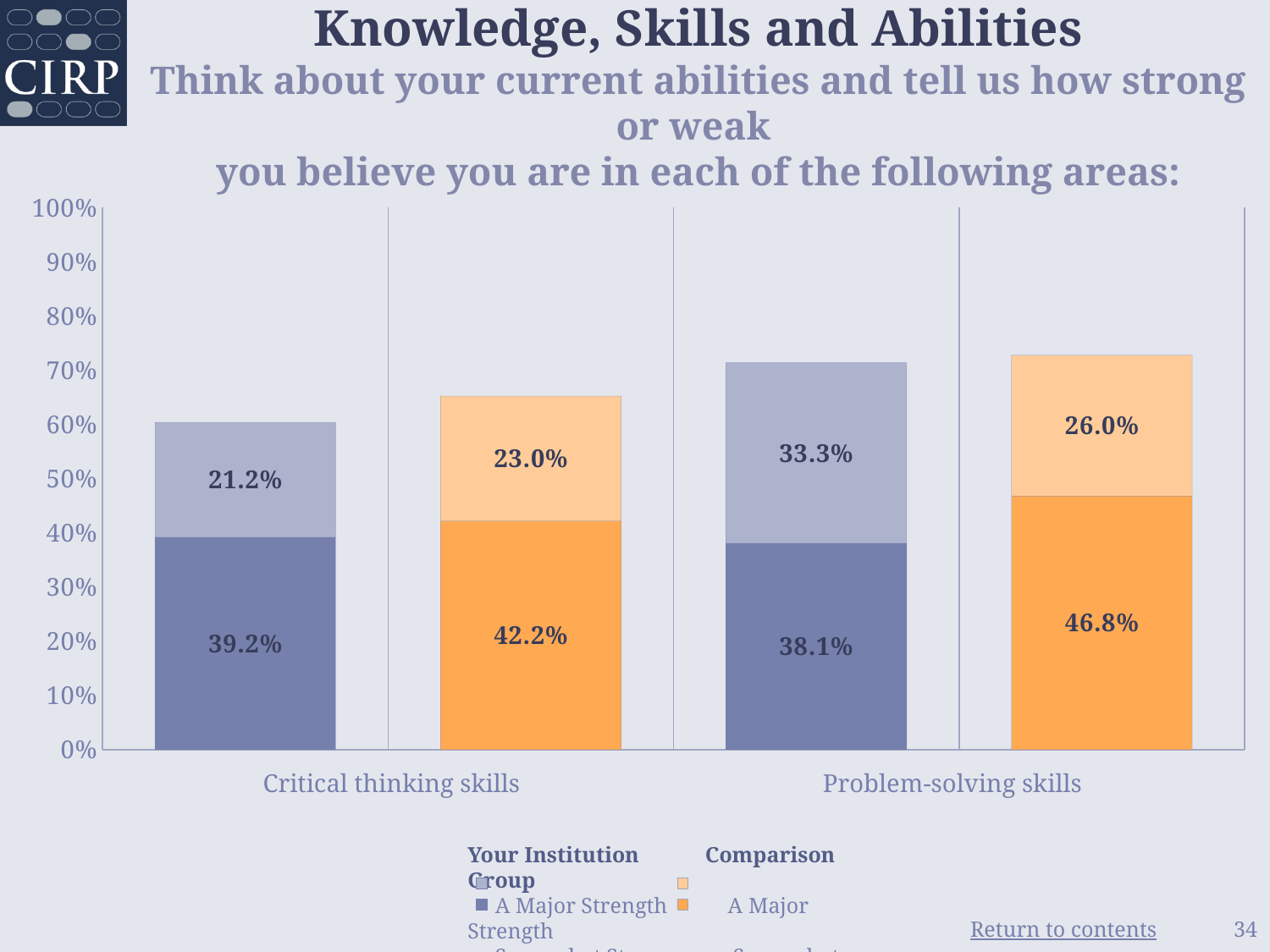
What is the difference between the Comparison Group and Your Institution 'A Major Strength' values for Problem-solving skills? 8.7% How many skill categories are shown on the x axis? 2 What is the total height of the Your Institution stacked bar for Critical thinking skills? 60.4% What kind of chart is shown on the slide? stacked bar chart Which bar has the highest 'A Major Strength' value? Comparison Group, Problem-solving skills What is the 'A Major Strength' value for Your Institution in Critical thinking skills? 39.2% What is the total height of the Comparison Group stacked bar for Problem-solving skills? 72.8% Is the total of the Your Institution bar for Problem-solving skills greater or less than 70%? greater What is the value of the upper (lighter) segment of the Comparison Group bar for Critical thinking skills? 23.0% What is the 'A Major Strength' value for the Comparison Group in Problem-solving skills? 46.8% What is the value of the upper (lighter) segment of the Your Institution bar for Problem-solving skills? 33.3% Is the 'A Major Strength' value for Your Institution in Critical thinking skills larger or smaller than the Comparison Group's value for the same skill? smaller